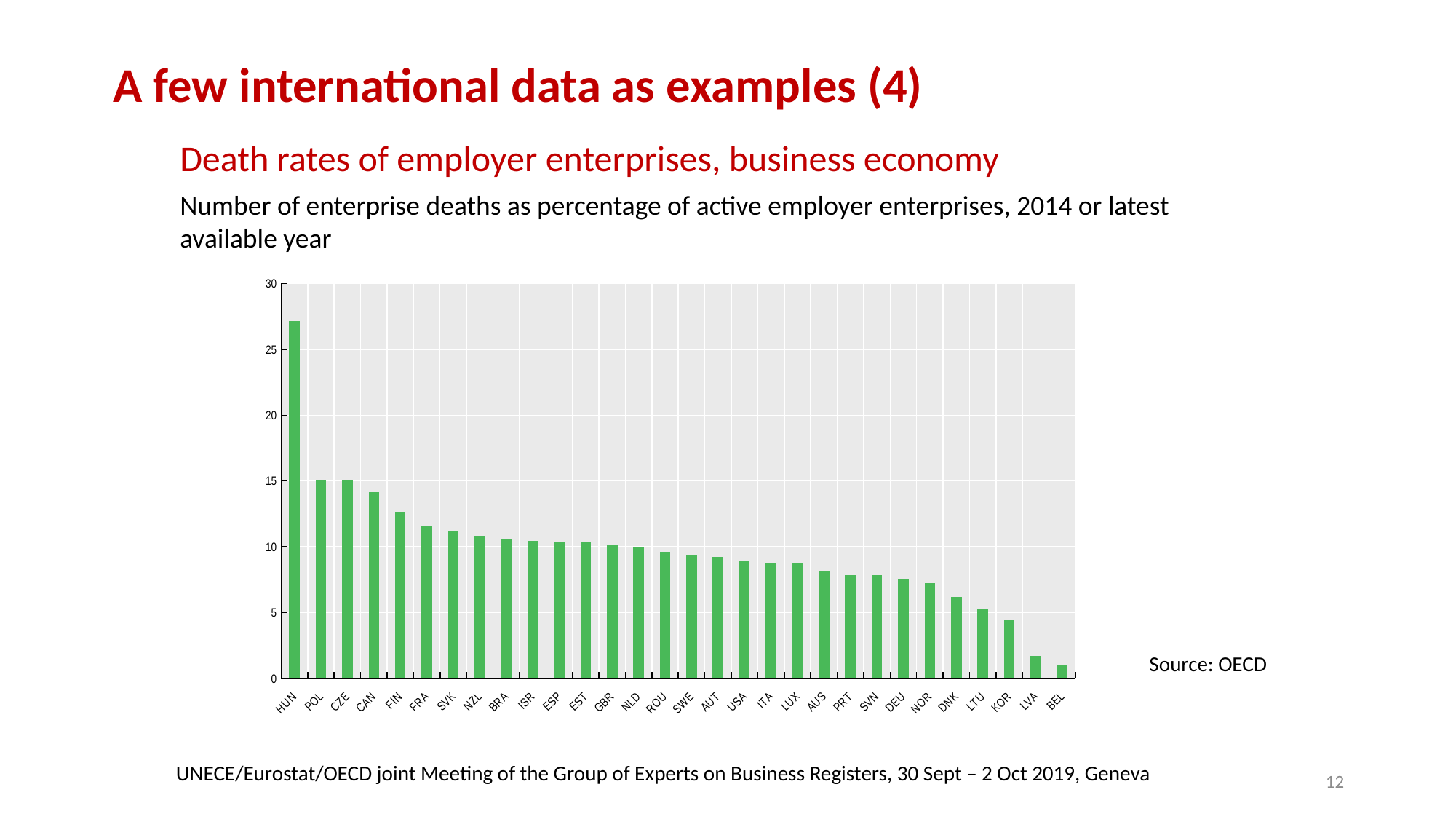
Which has a higher value, HUN or POL? HUN Is the value for KOR greater or less than 5? less Is the value for SWE greater or less than 10? less Which country has the highest death rate of employer enterprises in the chart? HUN What kind of chart is shown on the slide? bar chart Which has a higher value, LVA or KOR? KOR How many countries are shown in the chart? 30 Do the values rise or fall moving from left to right along the x axis? fall Is the value for HUN greater or less than 25? greater Which country has the lowest death rate of employer enterprises in the chart? BEL